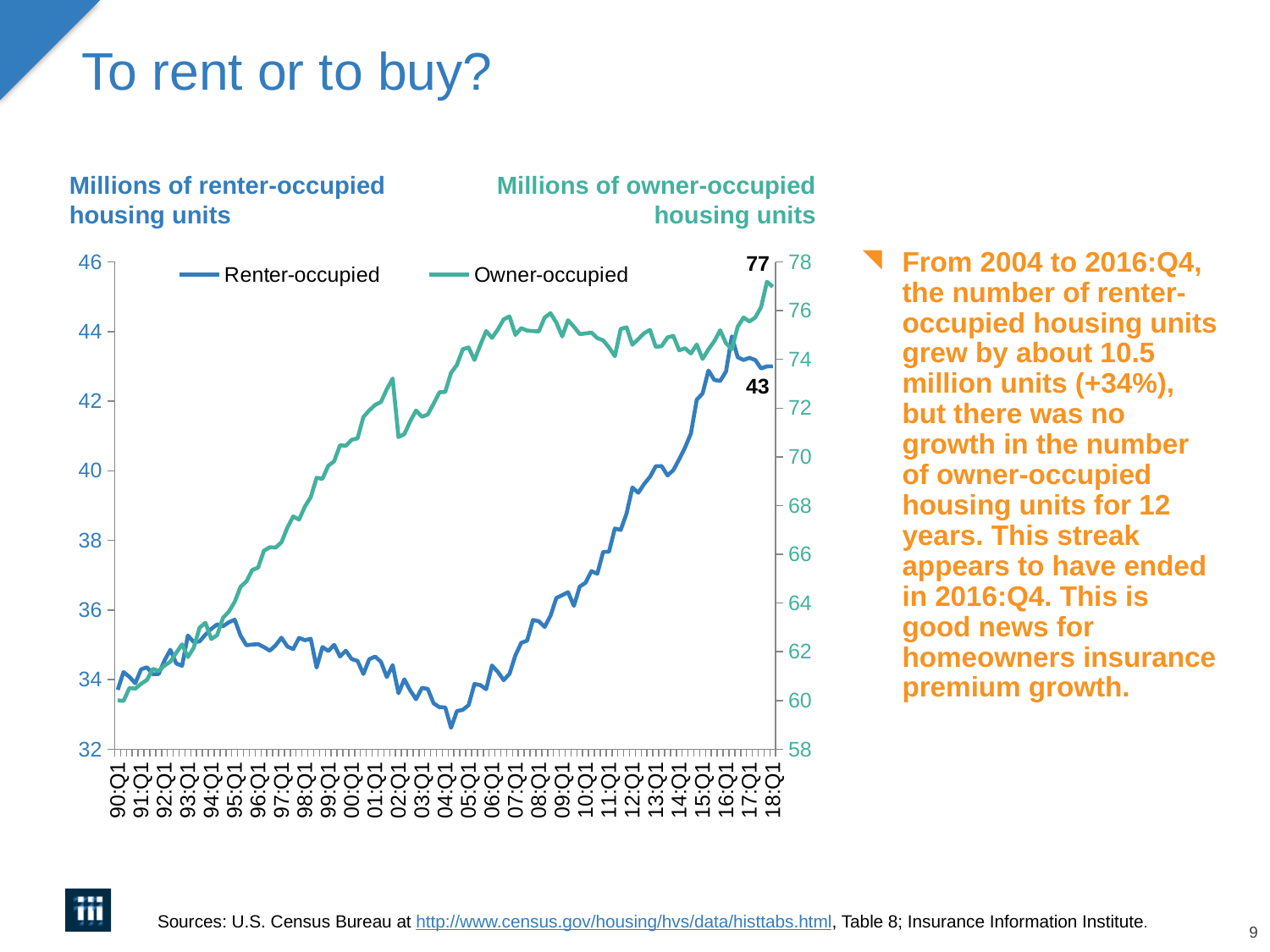
What is the labelled value of the Owner-occupied series at the end of the chart (18:Q1)? 77 How many series does the chart legend list? 2 Does the Owner-occupied series rise or fall between 90:Q1 and 07:Q1? rise Is the Renter-occupied value around 04:Q1 greater or less than 34? less Is the Owner-occupied value around 07:Q1 greater or less than 74? greater Does the Renter-occupied series rise or fall between 04:Q1 and 18:Q1? rise How many year labels are shown on the x axis? 29 What kind of chart is shown on the slide? line chart What is the labelled value of the Renter-occupied series at the end of the chart (18:Q1)? 43 Is the Renter-occupied value higher at 90:Q1 or at 18:Q1? 18:Q1 What is the label of the left-hand vertical axis? Millions of renter-occupied housing units